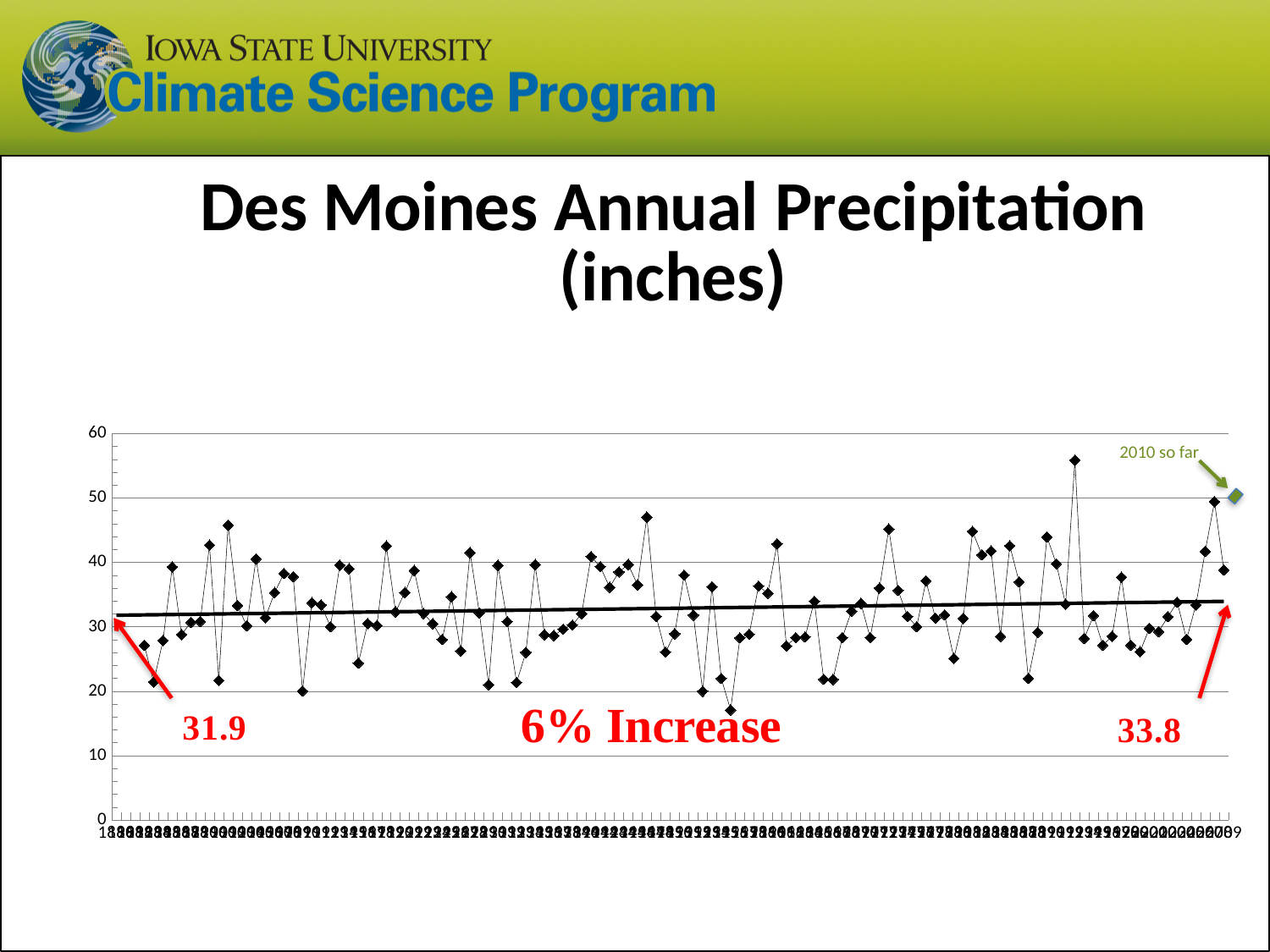
What value is labelled at the end of the trend line on the right of the chart? 33.8 What kind of chart is shown on the slide? line chart What is the maximum value shown on the y axis? 60 What value is labelled at the start of the trend line on the left of the chart? 31.9 Is the value for the point labelled "2010 so far" greater or less than 40? greater Is the lowest plotted annual precipitation value greater or less than 20? less What is the difference between the trend line's end value (33.8) and its start value (31.9)? 1.9 Is the highest plotted annual precipitation value greater or less than 50? greater Which is larger, the trend line's start value of 31.9 or its end value of 33.8? 33.8 What percentage change is annotated on the chart? 6% Increase Does the trend line rise or fall from left to right across the chart? rise What is the title of the chart? Des Moines Annual Precipitation (inches)